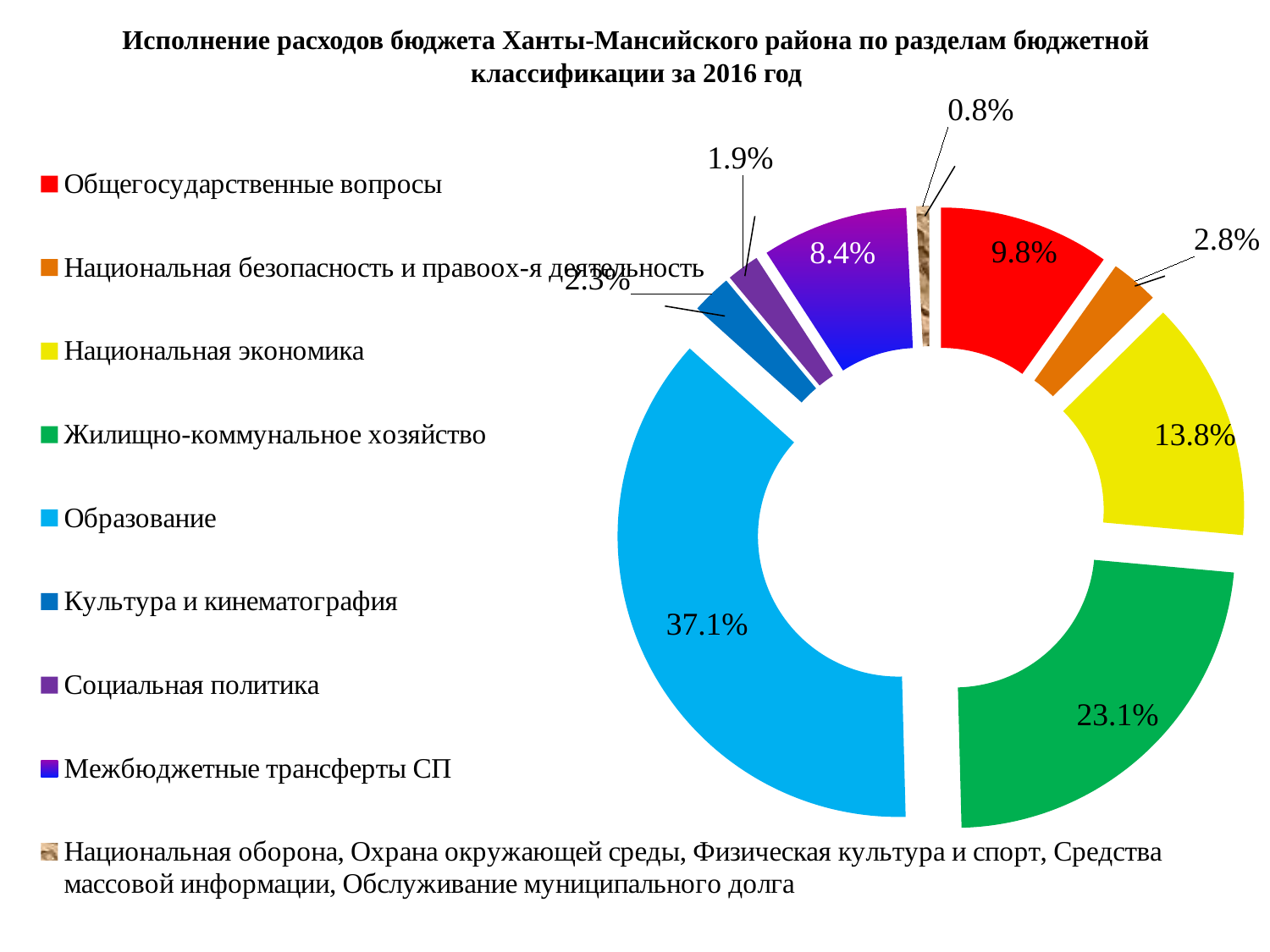
Which is larger, the share for Национальная экономика or the share for Общегосударственные вопросы? Национальная экономика What kind of chart is shown on the slide? Doughnut (pie) chart What share of the budget expenditure does Образование account for? 37.1% What percentage is shown for Национальная безопасность и правоох-я деятельность? 2.8% What percentage is shown for Жилищно-коммунальное хозяйство? 23.1% Which section has the smallest share of budget expenditure? Национальная оборона, Охрана окружающей среды, Физическая культура и спорт, Средства массовой информации, Обслуживание муниципального долга Which section has the largest share of budget expenditure? Образование What is the value for Национальная экономика? 13.8% What share does Межбюджетные трансферты СП have? 8.4% What is the difference in percentage points between Образование and Жилищно-коммунальное хозяйство? 14.0 What percentage is shown for Общегосударственные вопросы? 9.8% How many categories does the legend list? 9